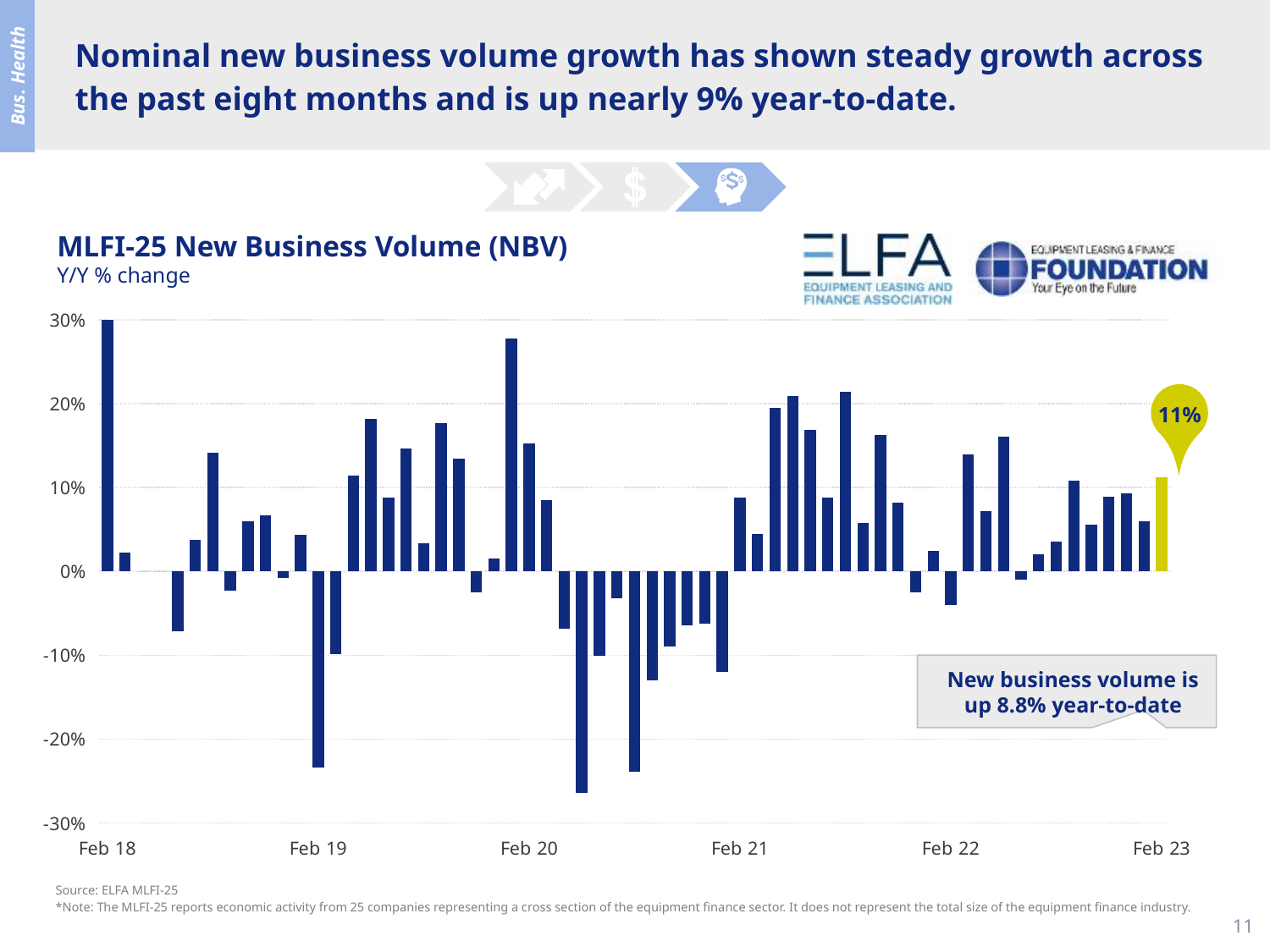
Which is larger, the value for Feb 20 or the value for Feb 21? Feb 20 Is the value for Feb 19 greater or less than -20%? less What is the title of the chart? MLFI-25 New Business Volume (NBV) Is the value for Feb 20 greater or less than 20%? less Is the value for Feb 23 greater or less than 10%? greater How many year labels are shown on the x axis? 6 What is the Y/Y % change in new business volume for Feb 23? 11% What kind of chart is shown on the slide? Bar chart Which is larger, the value for Feb 23 or the value for Feb 22? Feb 23 What colour is the bar for Feb 23? Yellow